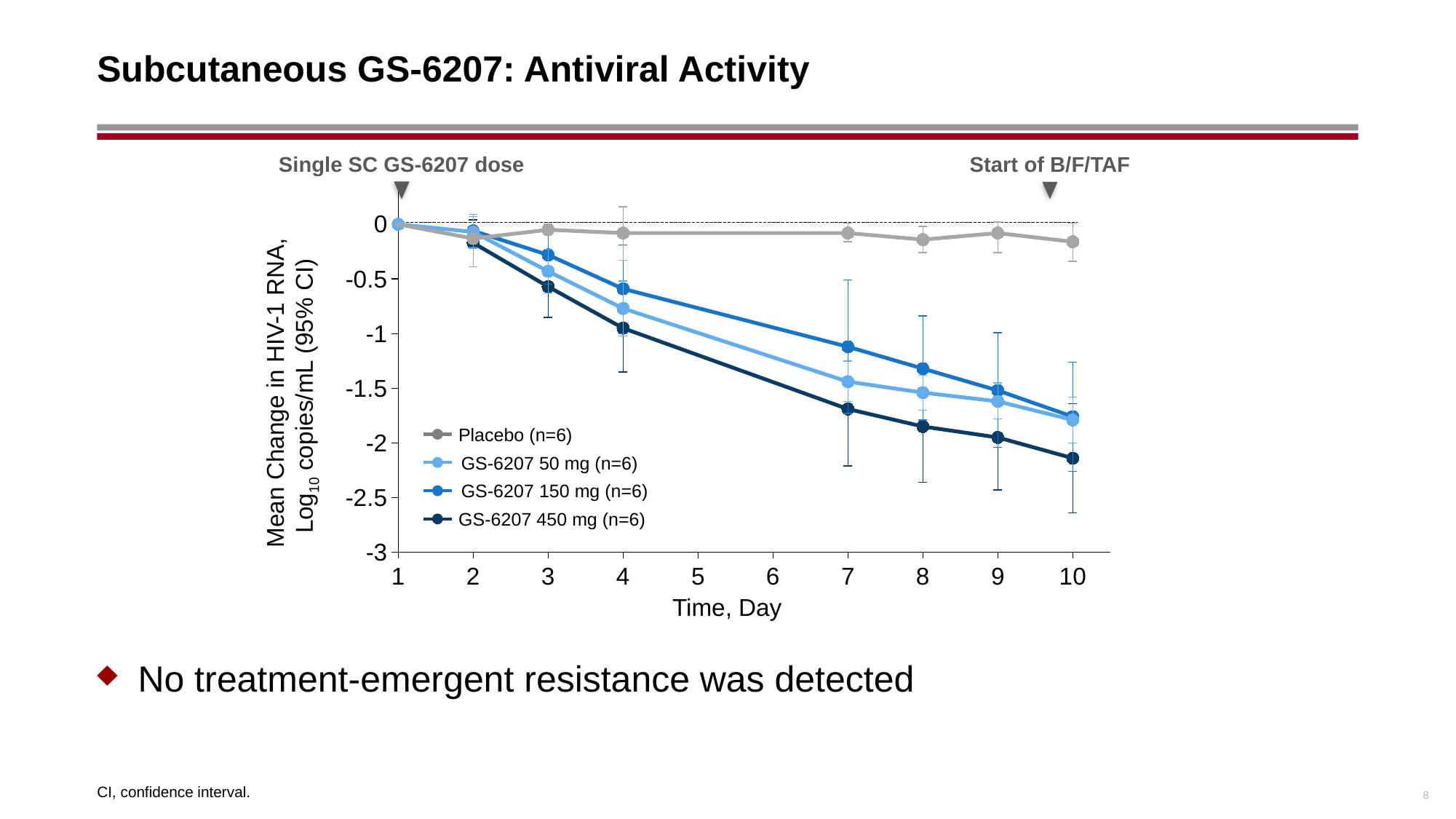
Is the value for GS-6207 50 mg at day 4 greater or less than -1? greater What kind of chart is shown on the slide? line chart How many series does the chart legend list? 4 Is the value for GS-6207 450 mg at day 10 greater or less than -1.5? less At day 7, which is lower: the value for GS-6207 450 mg or the value for GS-6207 150 mg? GS-6207 450 mg Do the values for GS-6207 450 mg rise or fall from day 1 to day 10? fall At day 10, which series has the lowest mean change in HIV-1 RNA? GS-6207 450 mg (n=6) What is the title of the x axis? Time, Day How many day labels are shown on the x axis? 10 Is the value for Placebo at day 10 greater or less than -0.5? greater